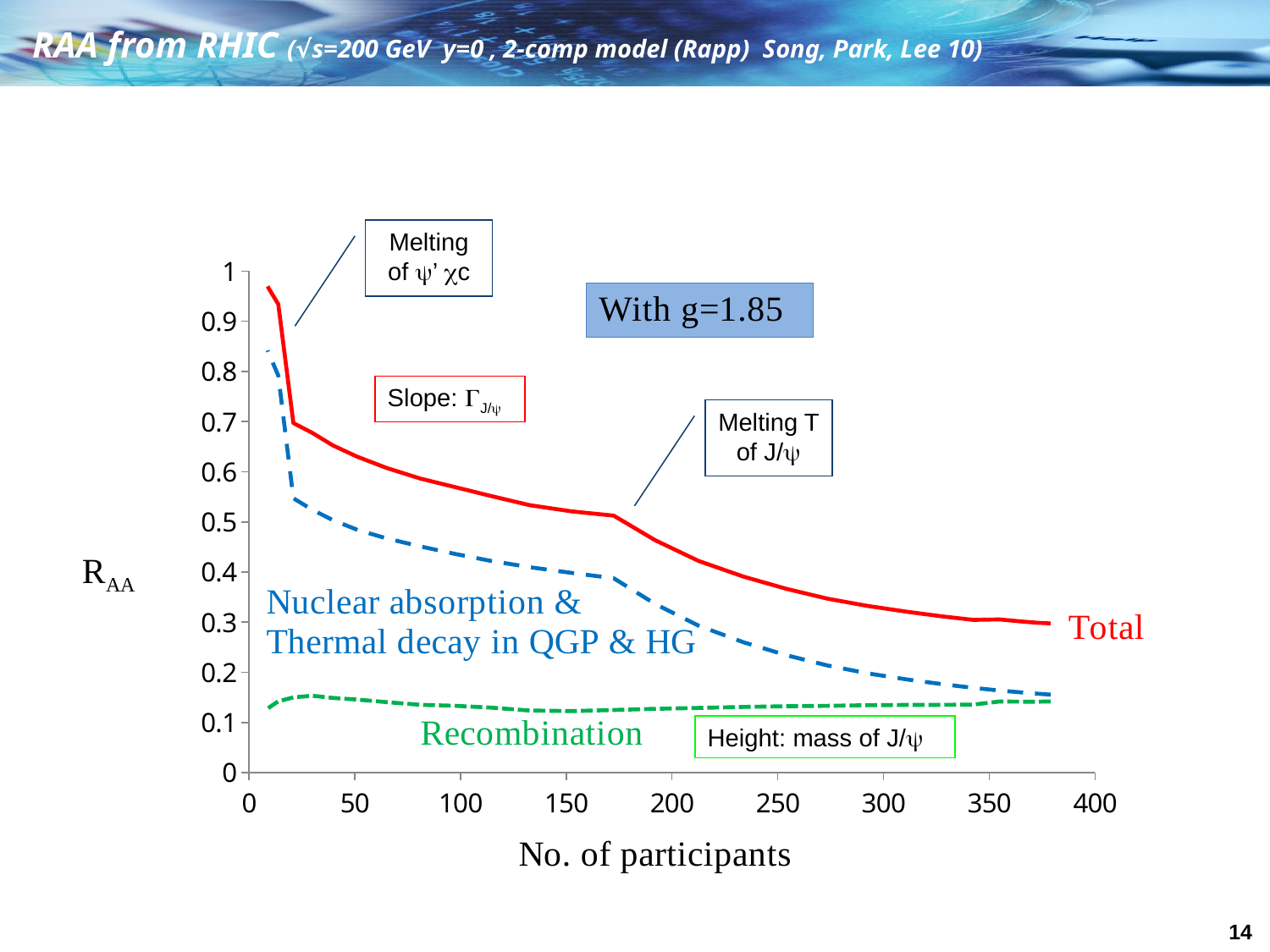
Which of the three curves is the highest across the whole range of participants? Total How many series (curves) are plotted on the chart? 3 Which of the three curves is the lowest across the whole range of participants? Recombination Is the value of the Total curve at 50 participants greater or less than 0.5? greater What kind of chart is shown on the slide? line chart Is the value of the Total curve at 350 participants greater or less than 0.5? less Does the Total curve rise or fall as the number of participants increases? fall What is the label of the x axis? No. of participants At 300 participants, which is larger: the Nuclear absorption & Thermal decay curve or the Recombination curve? Nuclear absorption & Thermal decay Is the value of the Recombination curve at 200 participants greater or less than 0.2? less What value of g is stated in the box on the chart? g=1.85